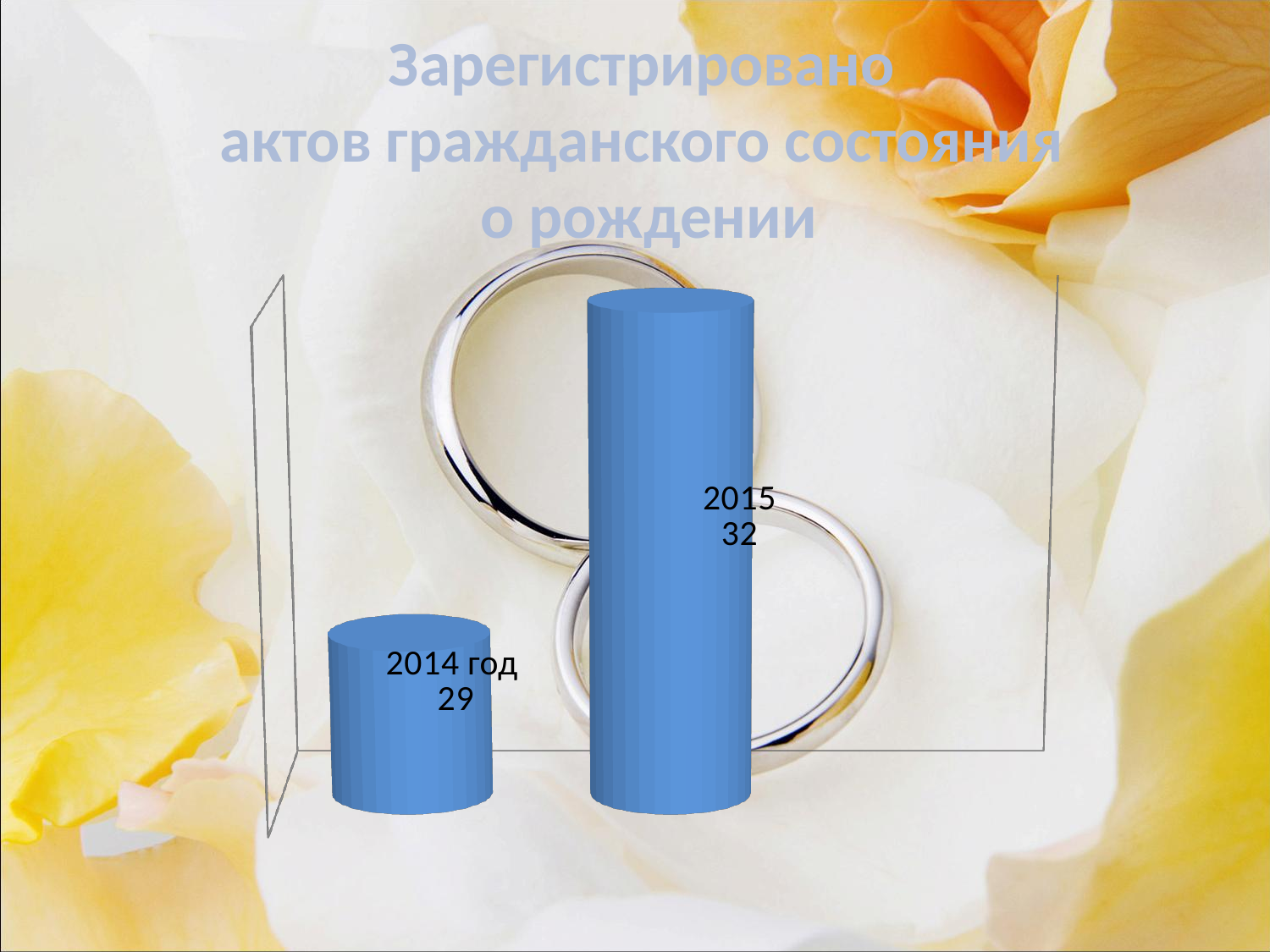
What is the difference between the values for 2015 and 2014 год? 3 Which category has the lowest value? 2014 год What is the title of the chart? Зарегистрировано актов гражданского состояния о рождении What colour are the bars in the chart? blue Do the values rise or fall from 2014 год to 2015? rise Which category has the highest value? 2015 Which is larger, the value for 2014 год or the value for 2015? 2015 What is the value for 2015? 32 What is the value for 2014 год? 29 What kind of chart is shown on the slide? bar chart How many categories are shown in the chart? 2